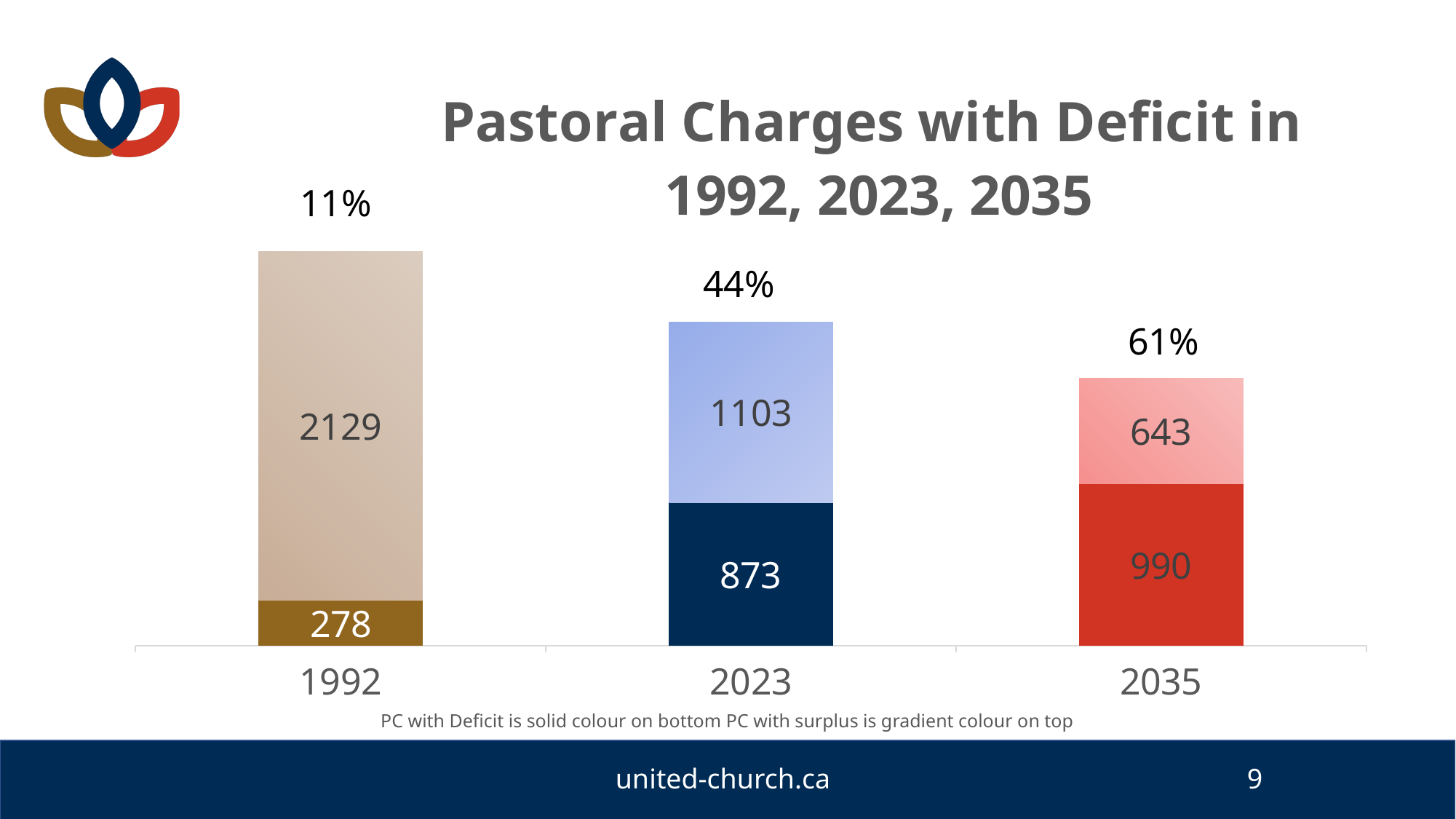
What is the number of pastoral charges with deficit in 2035? 990 Does the percentage of pastoral charges with deficit rise or fall from 1992 to 2035? Rise What is the number of pastoral charges with surplus in 2023? 1103 What is the total of the stacked bar for 2023? 1976 Which year has the lowest number of pastoral charges with surplus? 2035 What percentage is shown above the bar for 2023? 44% Is the number of pastoral charges with deficit larger in 2023 or in 2035? 2035 What is the difference between the number of pastoral charges with surplus in 1992 and in 2035? 1486 Which year has the highest number of pastoral charges with deficit? 2035 What is the number of pastoral charges with deficit in 1992? 278 What kind of chart is shown on the slide? Stacked bar chart How many years are shown on the x axis? 3